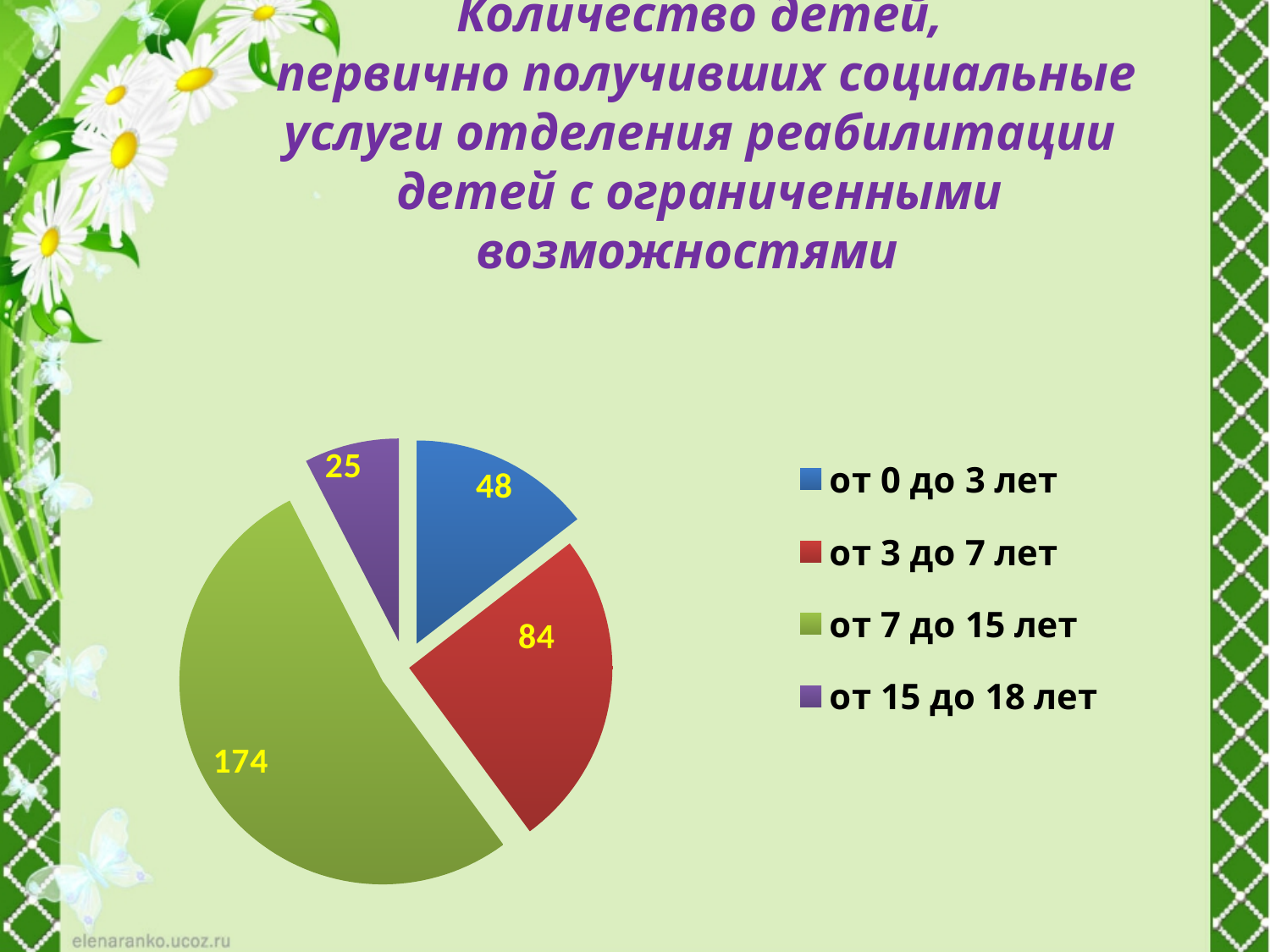
What is the value for the 'от 3 до 7 лет' slice? 84 What is the value for the 'от 0 до 3 лет' slice? 48 What is the value for the 'от 7 до 15 лет' slice? 174 What is the total of all four slices in the pie chart? 331 What kind of chart is shown on the slide? pie chart What is the difference between the values for 'от 7 до 15 лет' and 'от 3 до 7 лет'? 90 How many slices does the pie chart have? 4 What colour is the 'от 7 до 15 лет' slice in the pie chart? green Which is larger, the value for 'от 0 до 3 лет' or for 'от 3 до 7 лет'? от 3 до 7 лет Which age group has the largest slice? от 7 до 15 лет What is the value for the 'от 15 до 18 лет' slice? 25 Which age group has the smallest slice? от 15 до 18 лет